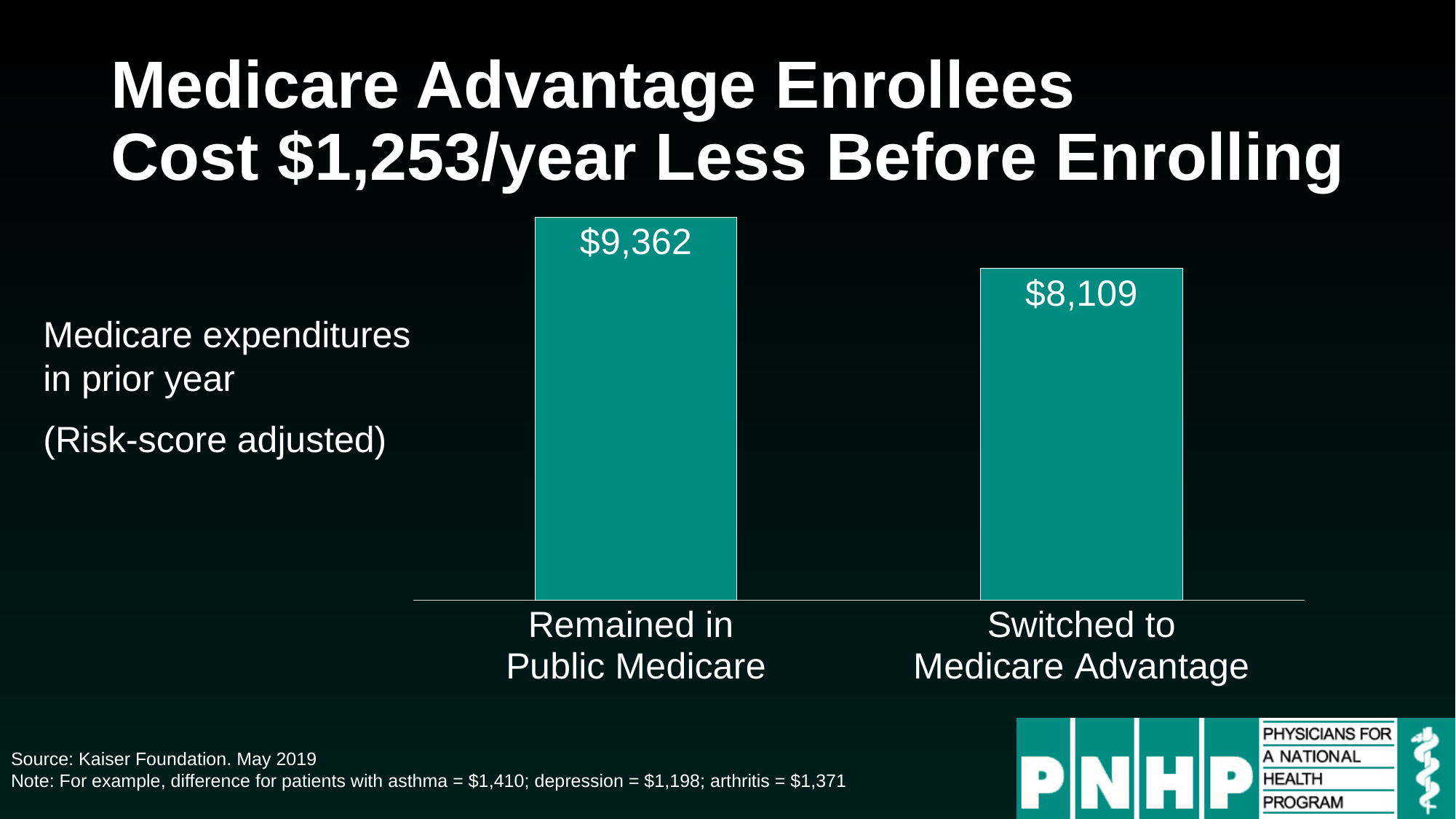
What is the value for Remained in Public Medicare? $9,362 What is the difference between the value for Remained in Public Medicare and the value for Switched to Medicare Advantage? $1,253 What is the value for Switched to Medicare Advantage? $8,109 Which category has the lowest value? Switched to Medicare Advantage How many categories are shown in the chart? 2 Which is larger: the value for Remained in Public Medicare or the value for Switched to Medicare Advantage? Remained in Public Medicare What is the title of the slide containing the chart? Medicare Advantage Enrollees Cost $1,253/year Less Before Enrolling Which category has the highest value? Remained in Public Medicare Do the values rise or fall from left to right across the categories? Fall What kind of chart is shown on the slide? Bar chart What colour are the bars in the chart? Teal